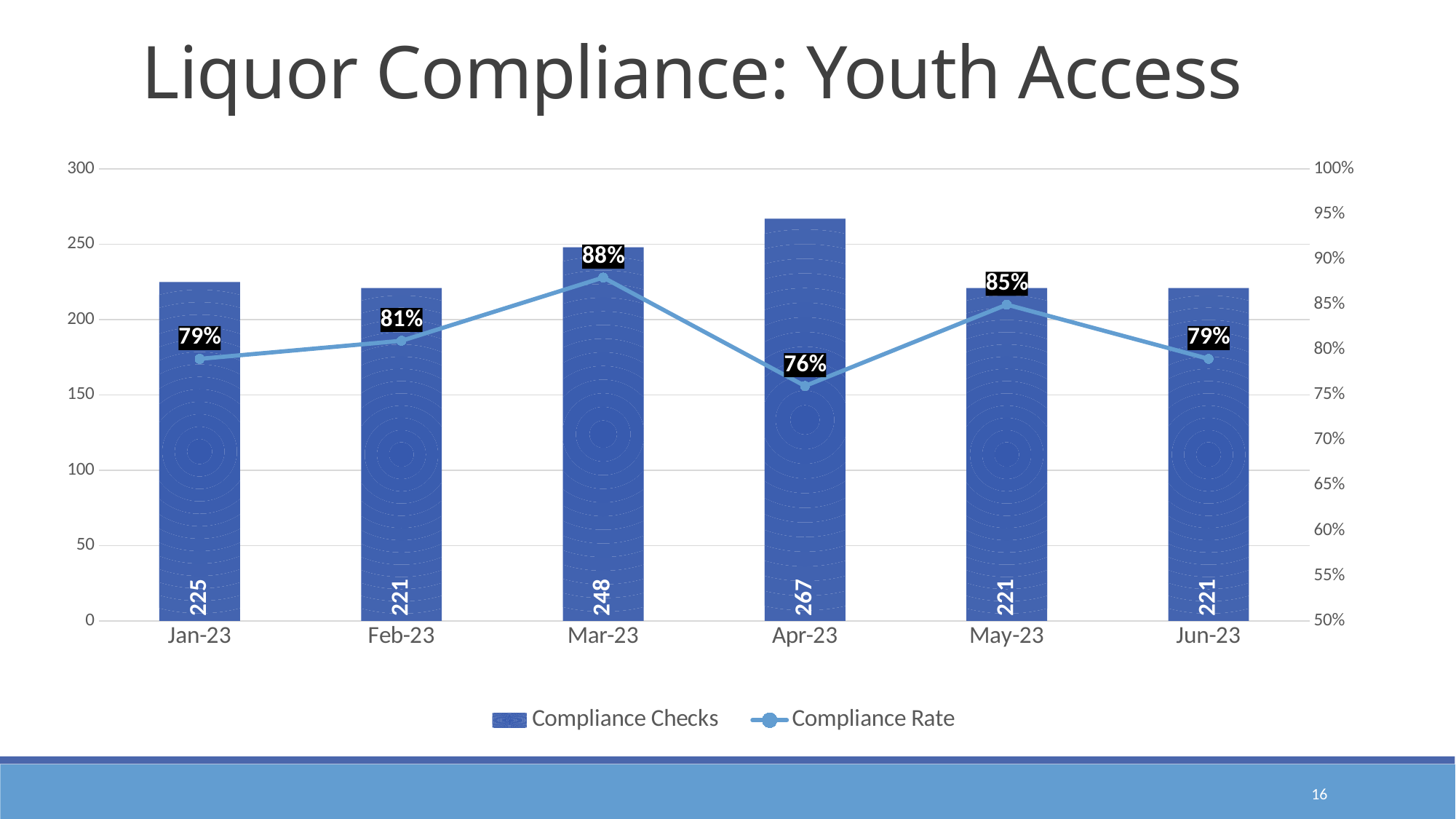
How many Compliance Checks were there in Apr-23? 267 What is the title of the slide? Liquor Compliance: Youth Access How many months are shown on the x axis? 6 What is the difference in Compliance Checks between Apr-23 and Mar-23? 19 Which is larger, the Compliance Rate in Feb-23 or in May-23? May-23 Is the number of Compliance Checks in Mar-23 greater or less than 200? greater What kind of chart is used to show Compliance Checks? bar chart Which month had the lowest Compliance Rate? Apr-23 How many series does the legend list? 2 Which month had the highest number of Compliance Checks? Apr-23 What is the difference in Compliance Rate between Mar-23 and Apr-23? 12% What was the Compliance Rate in Mar-23? 88%